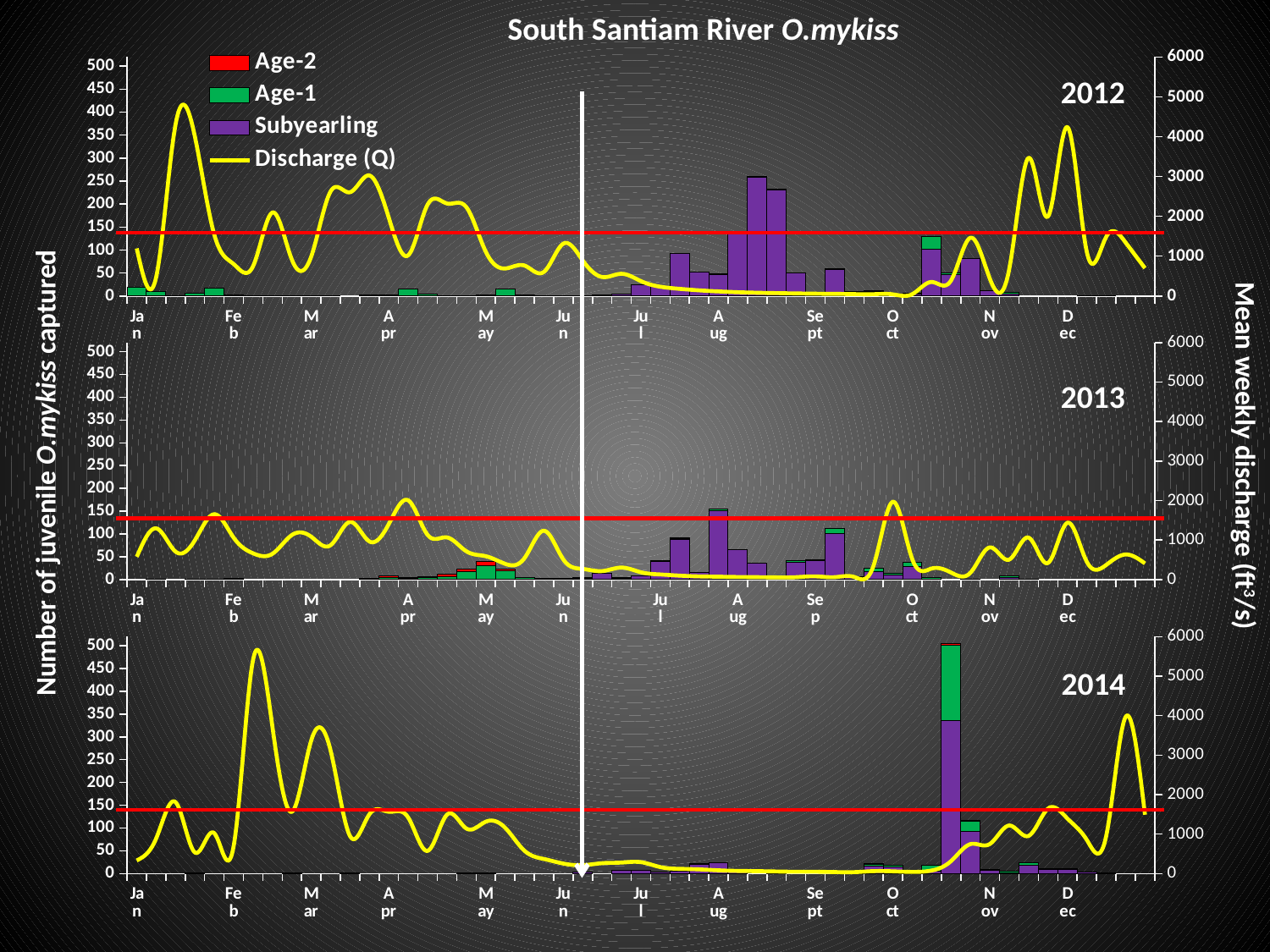
How many series does the legend list? 4 In the 2013 chart, is the tallest bar (in August) greater or less than 100 juveniles captured? greater What colour represents the Subyearling series? Purple How many yearly chart panels are shown on the slide? 3 In the 2014 chart, is the peak discharge in February greater or less than 5000 ft³/s? greater What kind of chart is used for each year's panel? Bar chart with a line In the 2012 chart, is the peak discharge in January greater or less than 4000 ft³/s? greater What is the title of the slide's charts? South Santiam River O.mykiss In the 2012 chart, which month has the tallest bar of juveniles captured? August Which year's chart contains the tallest bar of juveniles captured? 2014